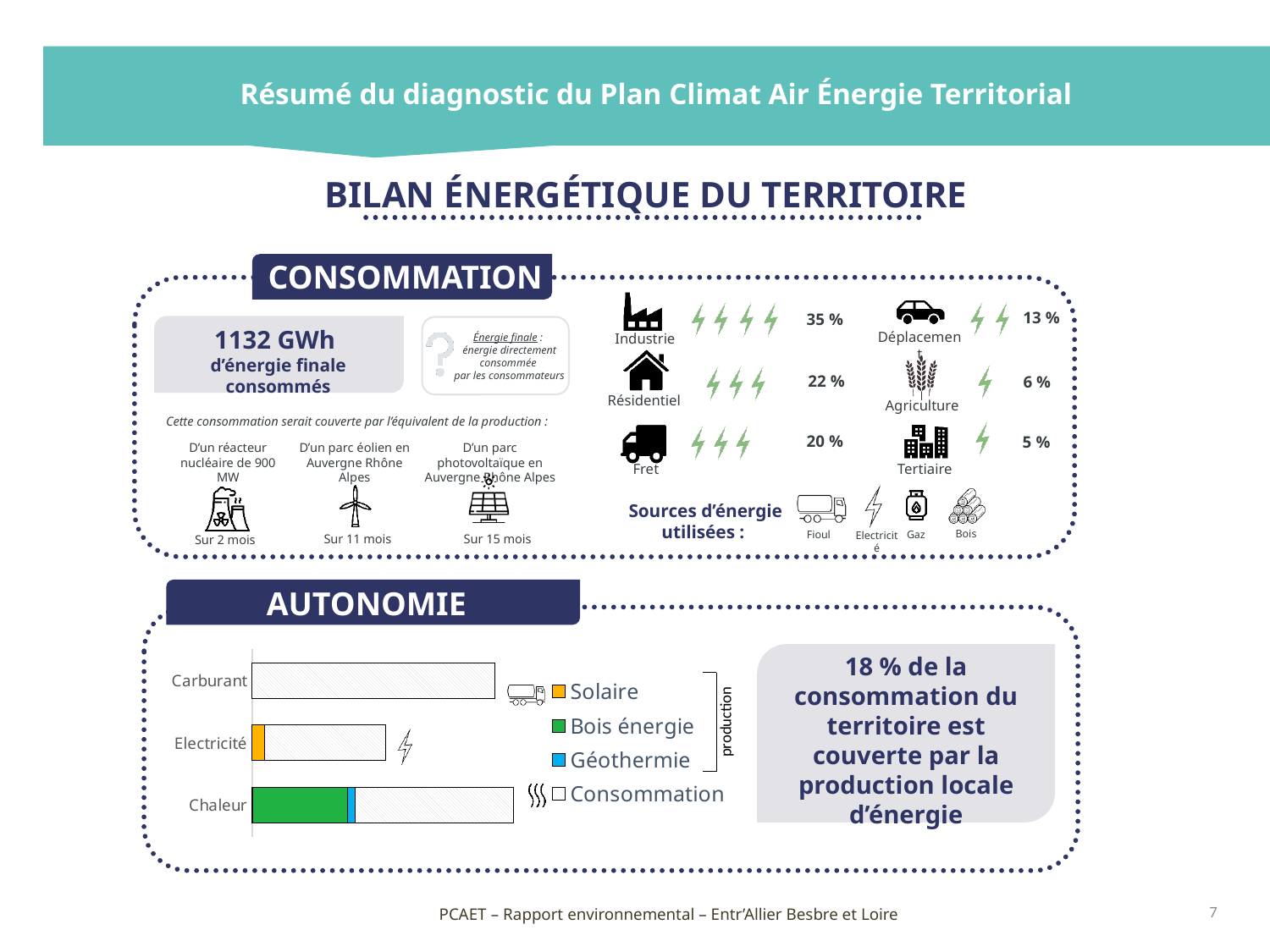
In the AUTONOMIE bar chart, which is larger: the Bois énergie segment for Chaleur or the Solaire segment for Electricité? Bois énergie segment for Chaleur In the AUTONOMIE bar chart, which category shows production from Bois énergie? Chaleur In the CONSOMMATION section, what is the difference between the shares of Résidentiel and Fret? 2 % How many series does the legend of the AUTONOMIE bar chart list? 4 How many categories does the AUTONOMIE bar chart show? 3 What are the legend entries of the AUTONOMIE bar chart? Solaire, Bois énergie, Géothermie, Consommation In the CONSOMMATION section, which sector has the lowest share of final energy consumption? Tertiaire What kind of chart is shown in the AUTONOMIE section? bar chart In the AUTONOMIE bar chart, which category shows production from Solaire? Electricité In the AUTONOMIE bar chart, which category has the shortest Consommation bar? Electricité In the AUTONOMIE bar chart, which colour represents Bois énergie? green In the CONSOMMATION section, what share of final energy consumption is attributed to Industrie? 35 %